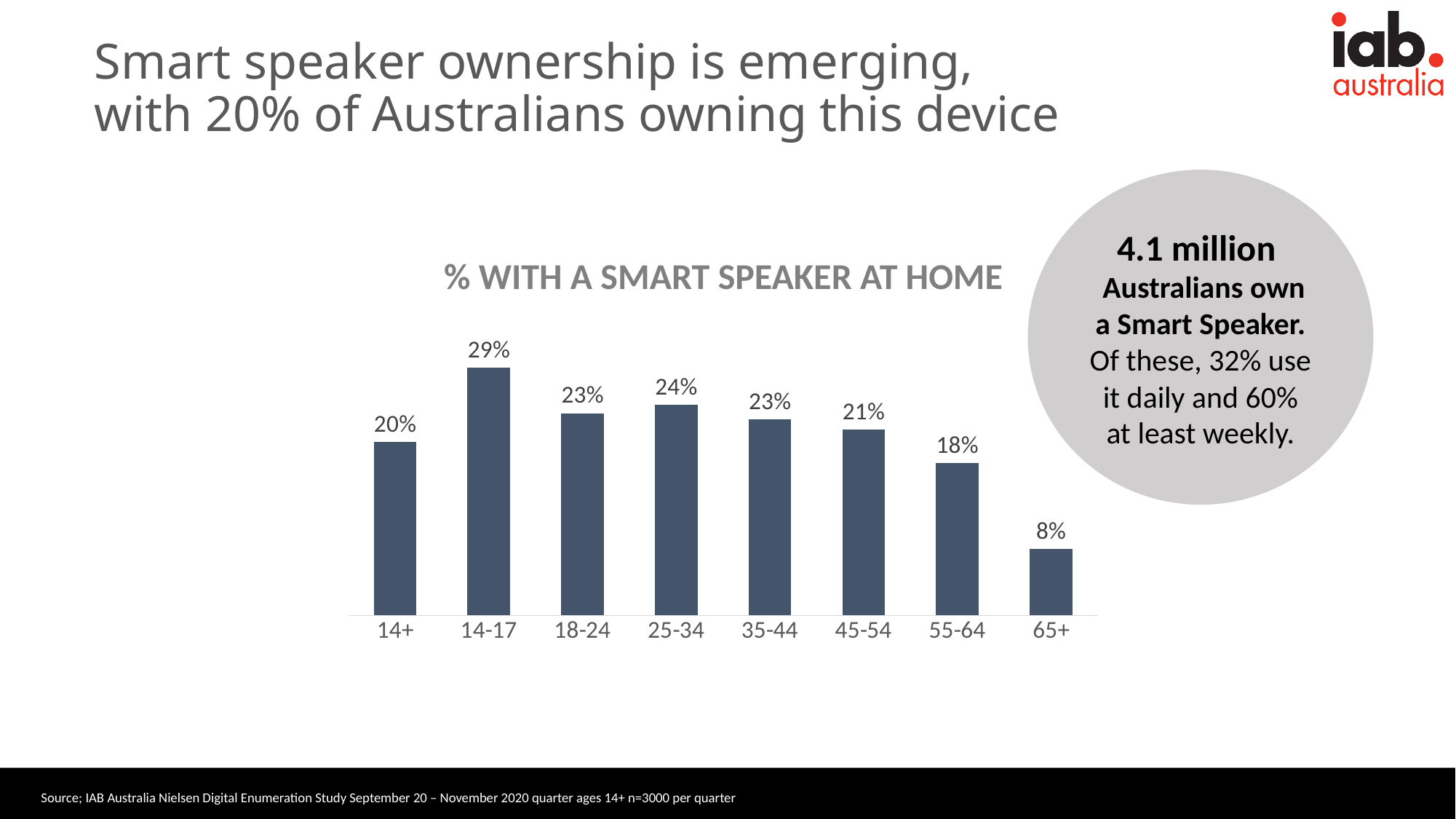
What is the value for the 45-54 age group? 21% What kind of chart is shown on the slide? Bar chart Which is larger, the value for 25-34 or the value for 45-54? 25-34 What is the value for the 65+ age group? 8% Which age group has the lowest percentage with a smart speaker at home? 65+ What is the difference between the values for 14-17 and 65+? 21% What is the title of the chart? % WITH A SMART SPEAKER AT HOME Which age group has the highest percentage with a smart speaker at home? 14-17 What is the difference between the values for 25-34 and 55-64? 6% What is the value for the 14+ category? 20% What is the value for the 14-17 age group? 29% How many categories are shown on the x axis? 8